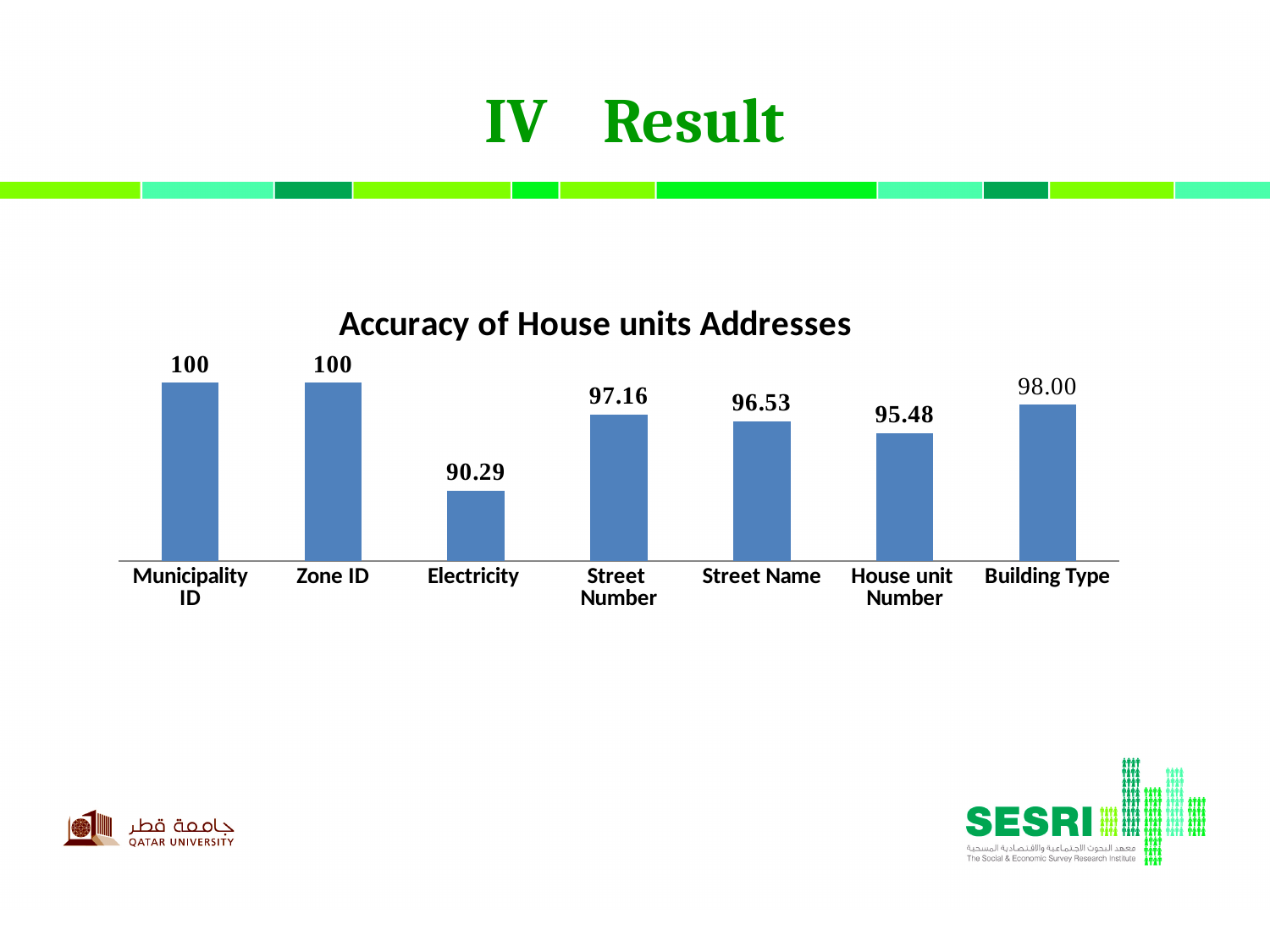
What is the title of the chart? Accuracy of House units Addresses What is the value for Building Type? 98.00 What is the difference between the values for Street Number and Street Name? 0.63 What is the value for Electricity? 90.29 Which is larger, the value for Street Name or the value for House unit Number? Street Name What kind of chart is shown? bar chart Which category has the lowest value? Electricity What is the value for House unit Number? 95.48 Which is larger, the value for Building Type or the value for Street Number? Building Type How many categories are shown on the x axis? 7 What is the difference between the values for Zone ID and Electricity? 9.71 What is the value for Street Number? 97.16